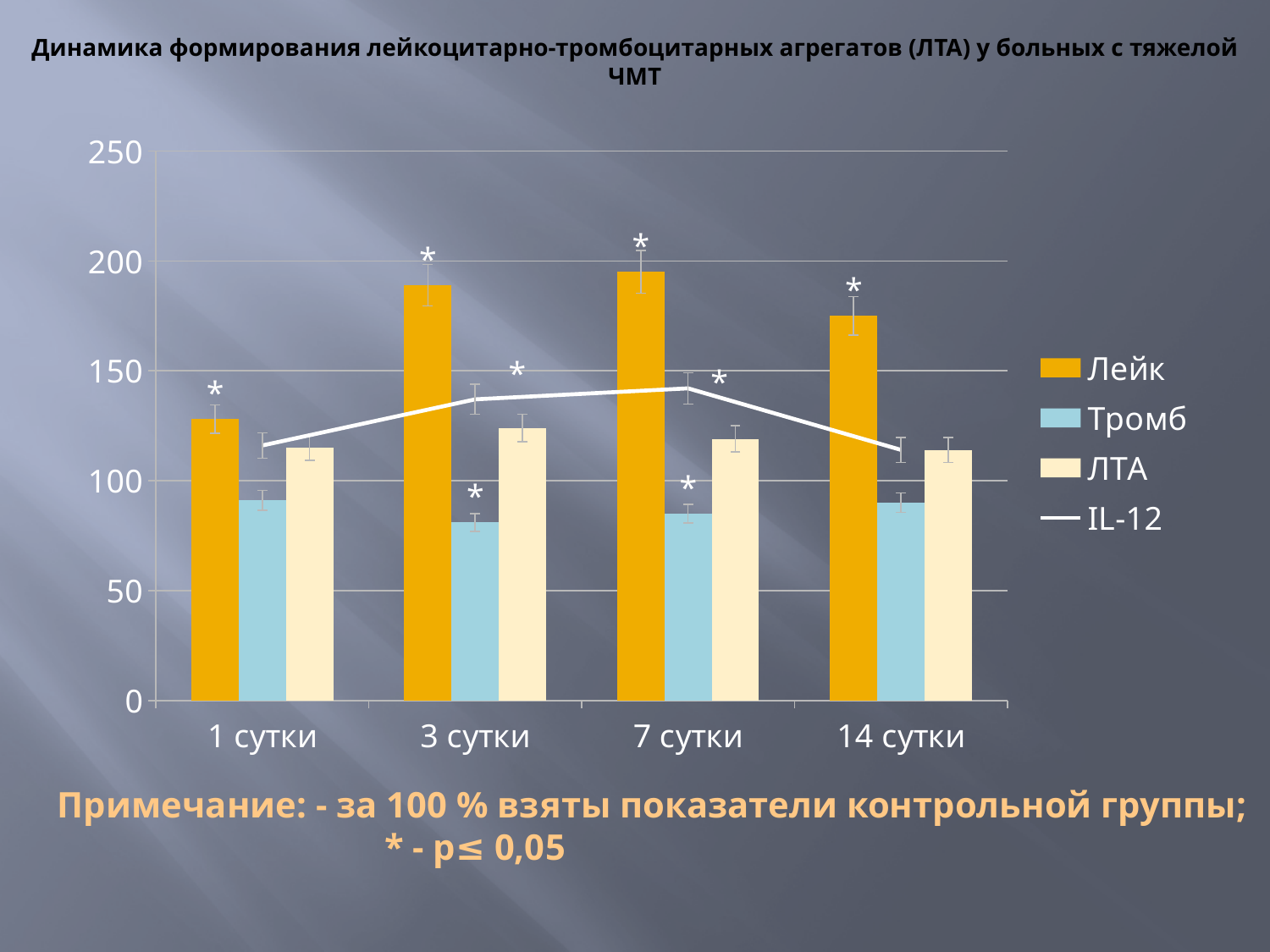
How many categories are shown on the x axis of the chart? 4 Is the value for Лейк at 14 сутки greater or less than 150? greater At which time point is the Лейк bar the highest? 7 сутки Is the value for Тромб at 1 сутки greater or less than 100? less At 7 сутки, which is larger: Лейк or Тромб? Лейк What kind of chart is shown on the slide? bar chart with a line series Does the IL-12 line rise or fall from 7 сутки to 14 сутки? fall At which time point is the Лейк bar the lowest? 1 сутки How many series does the chart legend list? 4 Which series is drawn as a line rather than bars? IL-12 Is the value for ЛТА at 3 сутки greater or less than 100? greater